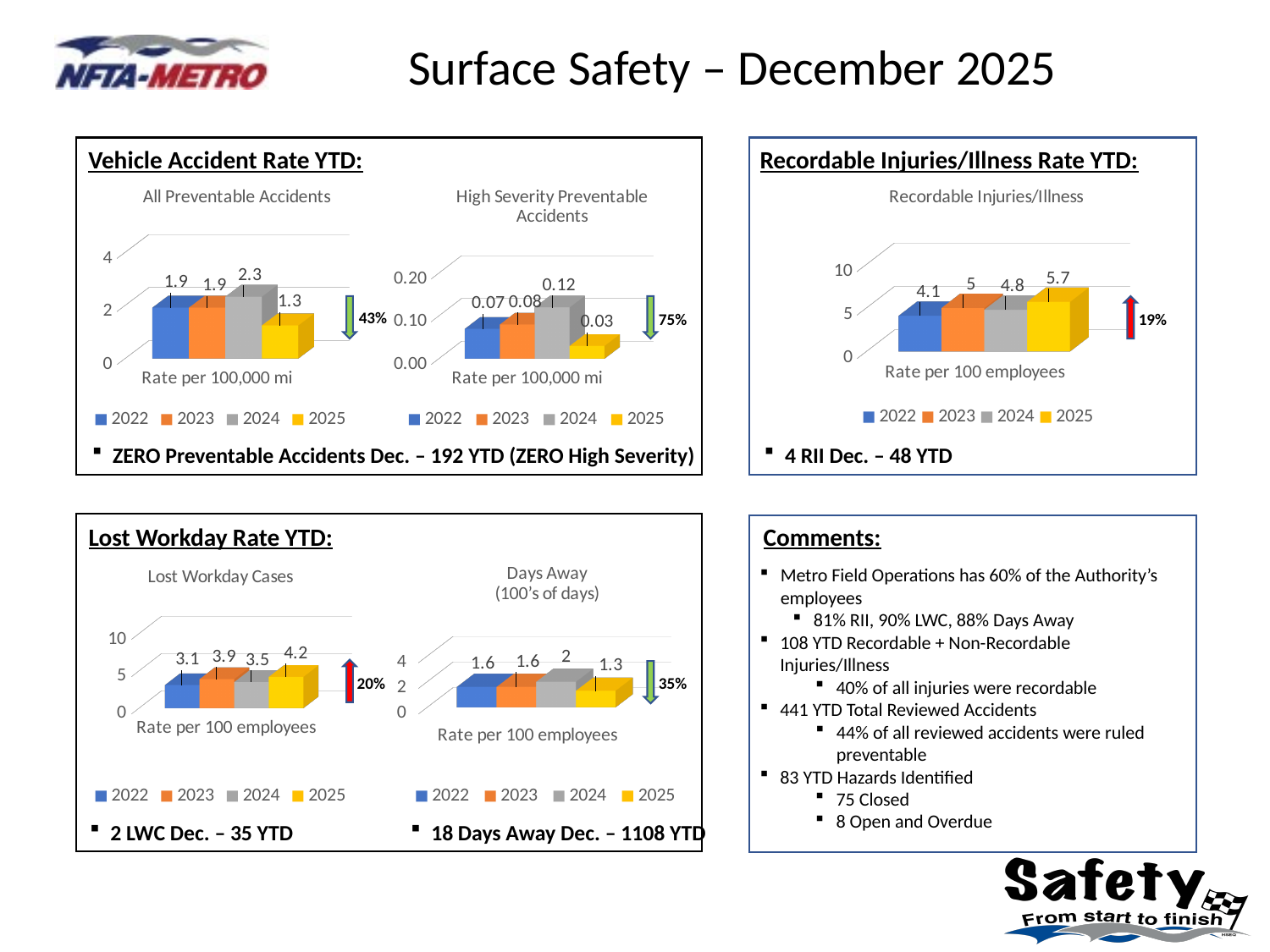
In the "Recordable Injuries/Illness" chart, what is the difference between the 2025 and 2022 values? 1.6 In the "High Severity Preventable Accidents" chart, which year has the lowest value? 2025 In the "Recordable Injuries/Illness" chart, what is the value for 2025? 5.7 In the "High Severity Preventable Accidents" chart, what is the value for 2024? 0.12 In the "All Preventable Accidents" chart, what is the value for 2025? 1.3 How many series does the legend of the "Recordable Injuries/Illness" chart list? 4 In the "Lost Workday Cases" chart, which year has the highest value? 2025 In the "Days Away (100's of days)" chart, what is the difference between the 2024 and 2025 values? 0.7 In the "All Preventable Accidents" chart, which year has the highest value? 2024 What kind of chart is the "Lost Workday Cases" chart? Bar chart In the "Days Away (100's of days)" chart, what is the value for 2024? 2 In the "Lost Workday Cases" chart, is the value for 2023 larger or smaller than the value for 2024? larger